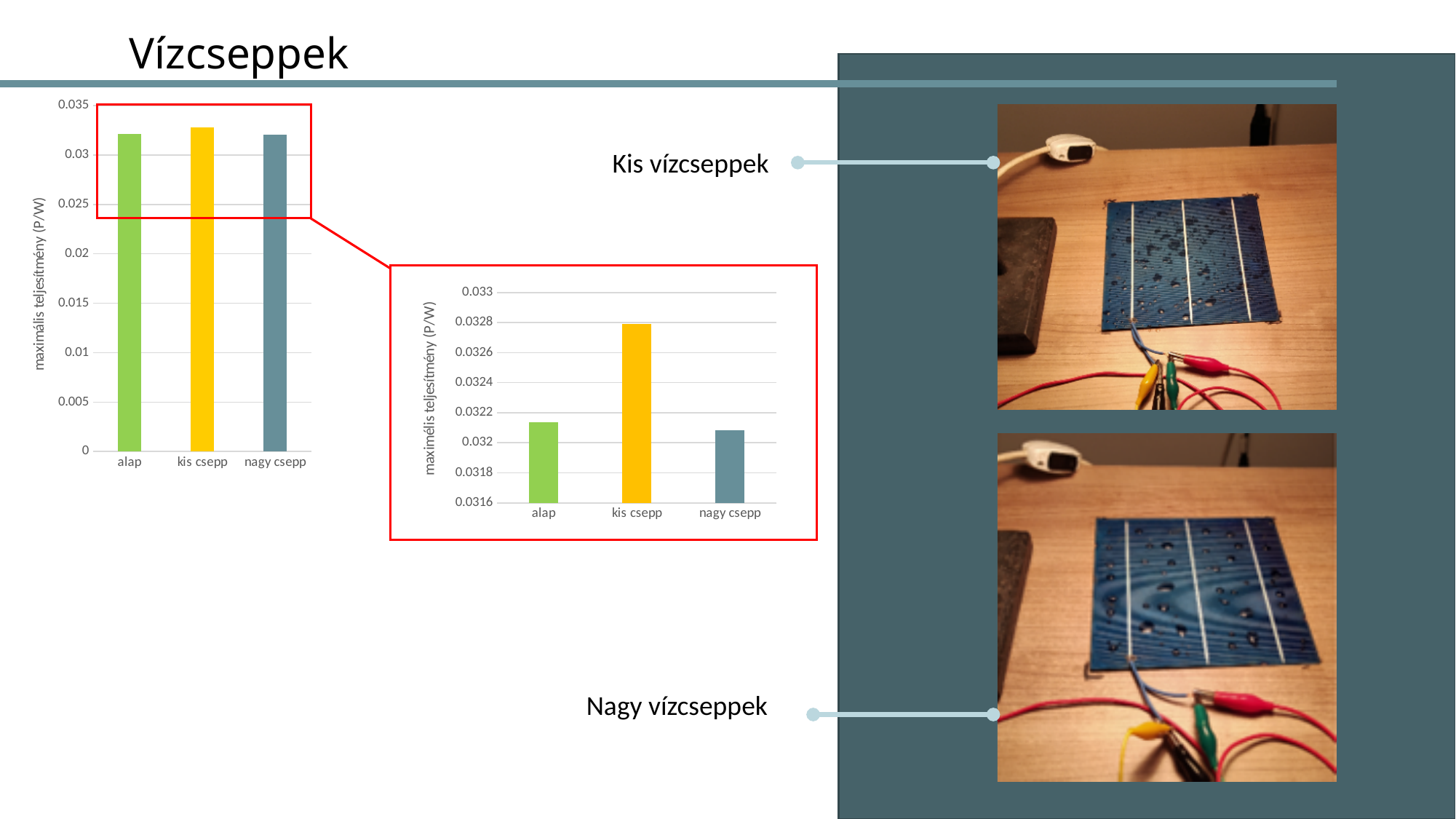
In the zoomed-in chart inside the red box, which is larger, the value for kis csepp or the value for nagy csepp? kis csepp What is the y-axis label of the chart on the left? maximális teljesítmény (P/W) What kind of chart is the chart on the left of the slide? bar chart In the zoomed-in chart inside the red box, which is larger, the value for alap or the value for kis csepp? kis csepp In the chart on the left, is the value for nagy csepp greater or less than 0.035? less In the zoomed-in chart inside the red box, which category has the highest value? kis csepp In the chart on the left, is the value for alap greater or less than 0.03? greater In the zoomed-in chart inside the red box, is the value for kis csepp greater or less than 0.0326? greater In the chart on the left, what colour is the bar for kis csepp? yellow How many categories are shown on the x axis of the chart on the left? 3